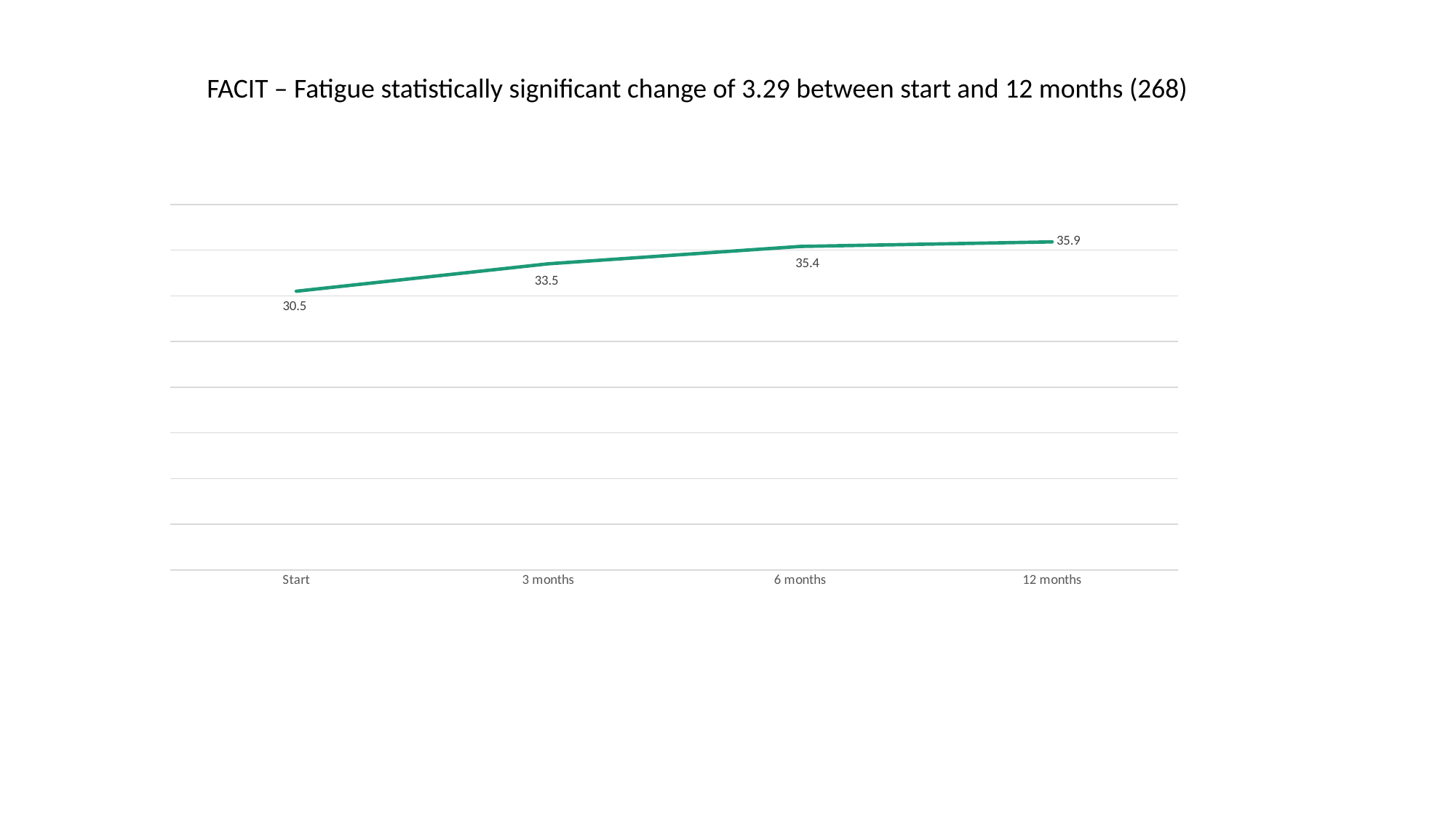
Which time point has the lowest value? Start Which is larger, the value at 6 months or the value at 3 months? 6 months What is the value at 12 months? 35.9 Do the values rise or fall from Start to 12 months? rise How many time points are plotted on the chart? 4 Which time point has the highest value? 12 months What is the difference between the value at 3 months and the value at Start? 3 What kind of chart is shown? line chart What is the difference between the value at 12 months and the value at Start? 5.4 What is the value at 6 months? 35.4 What is the value at 3 months? 33.5 What is the value at Start? 30.5